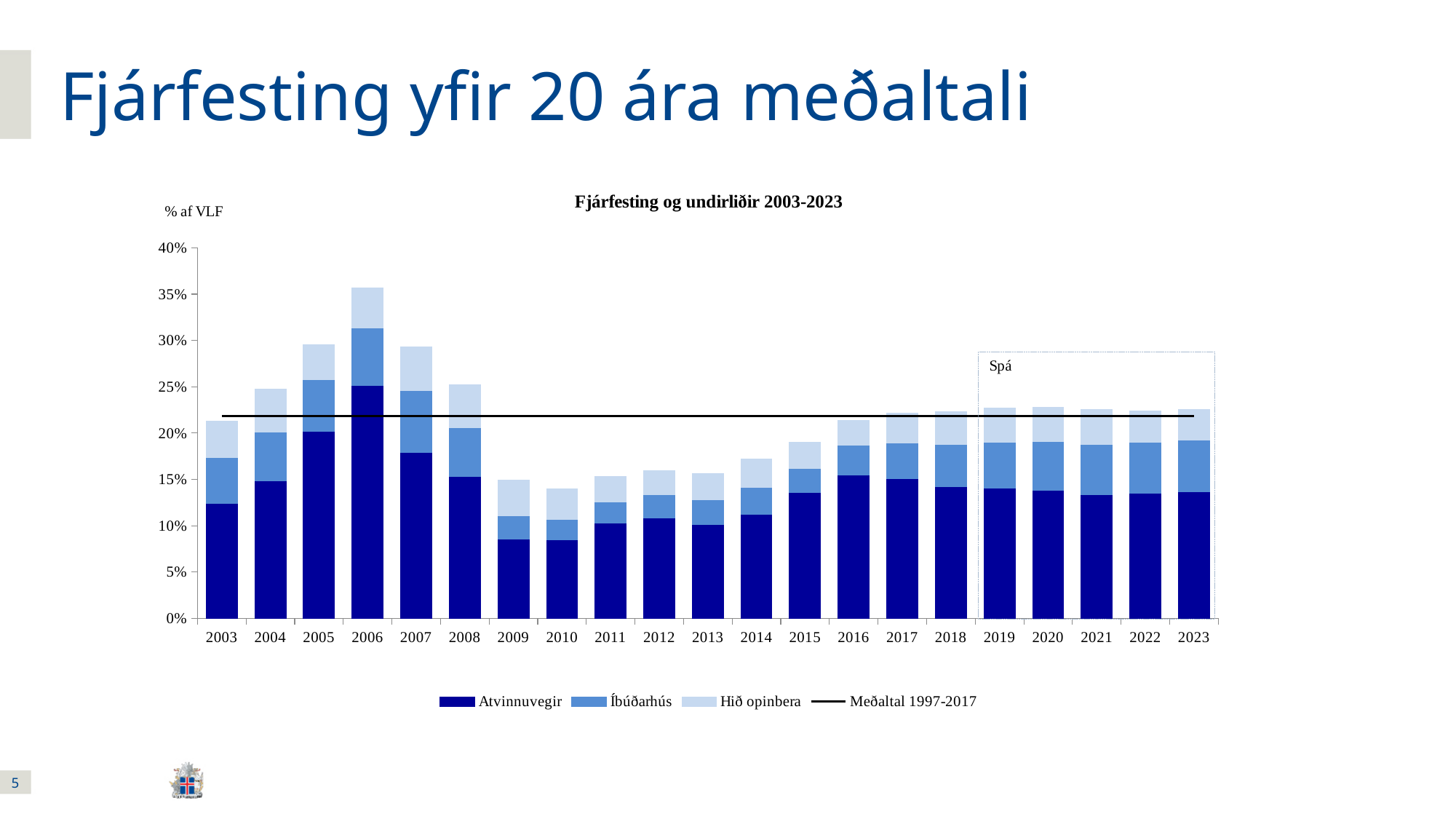
Which year has the highest total investment bar? 2006 How many entries does the chart's legend list? 4 What kind of chart is shown on the slide? bar chart Do the total bars rise or fall from 2006 to 2010? fall Is the Atvinnuvegir segment for 2006 greater or less than 20%? greater Which year has the tallest Atvinnuvegir segment? 2006 Is the Meðaltal 1997-2017 line greater or less than 20%? greater How many years are shown on the x axis of the chart? 21 Is the total bar for 2010 greater or less than 15%? less Which year has the lowest total investment bar? 2010 Which year has the larger total bar, 2003 or 2004? 2004